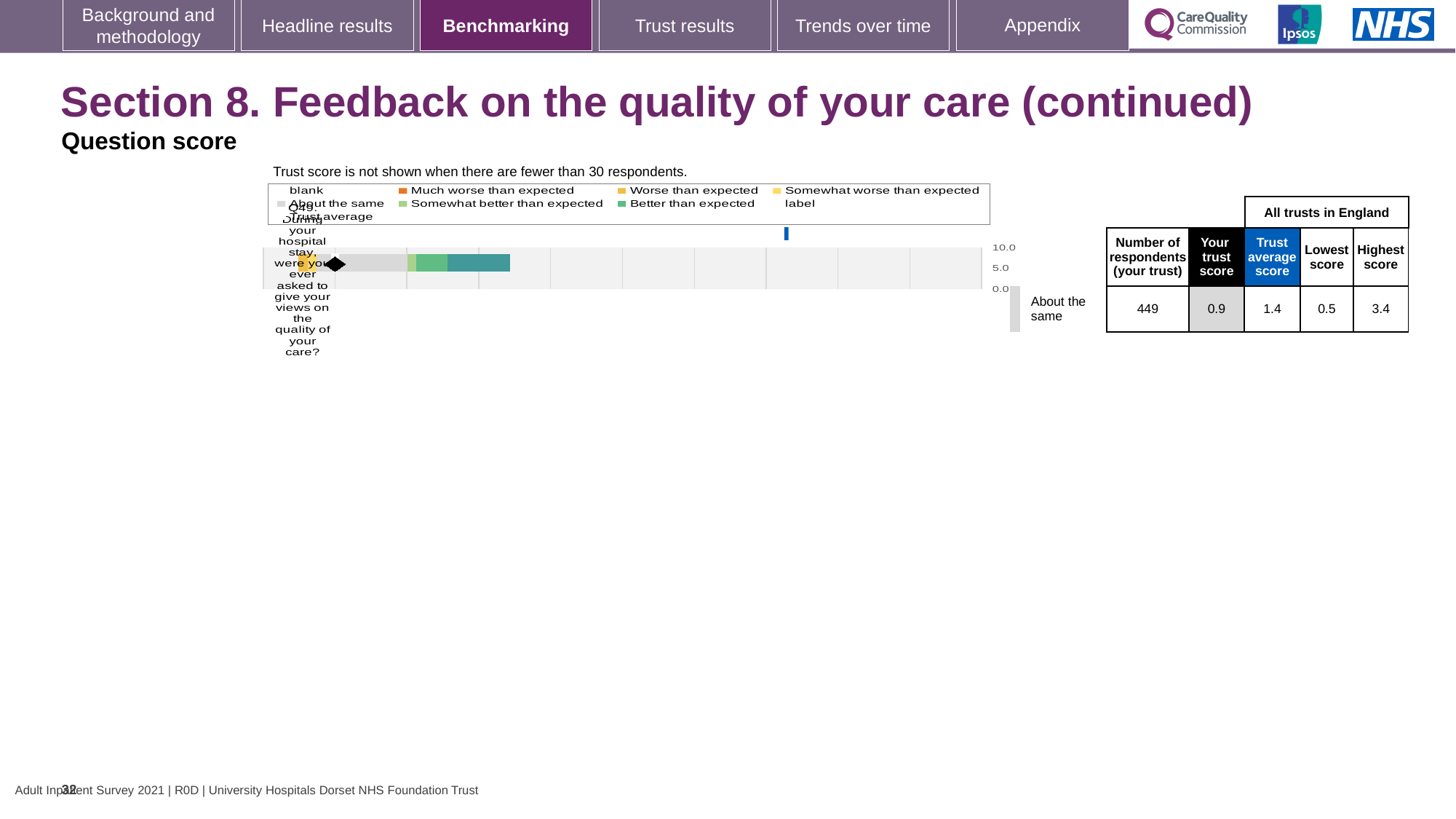
What is the trust average score for Q49 shown in the table? 1.4 What kind of chart is shown on the slide for Q49? bar chart What is the lowest score among all trusts in England for Q49? 0.5 How many respondents from the trust answered Q49? 449 Which is larger for Q49: the trust's score or the trust average score? Trust average score What is the highest score among all trusts in England for Q49? 3.4 What benchmark category is the trust's Q49 result labelled as? About the same Which legend entry is shown in orange? Much worse than expected According to the table next to the chart, what is the trust's score for Q49? 0.9 What is the difference between the highest and lowest scores for Q49 across all trusts in England? 2.9 How many survey questions are plotted in the chart? 1 By how much does the trust average score exceed the trust's own score for Q49? 0.5